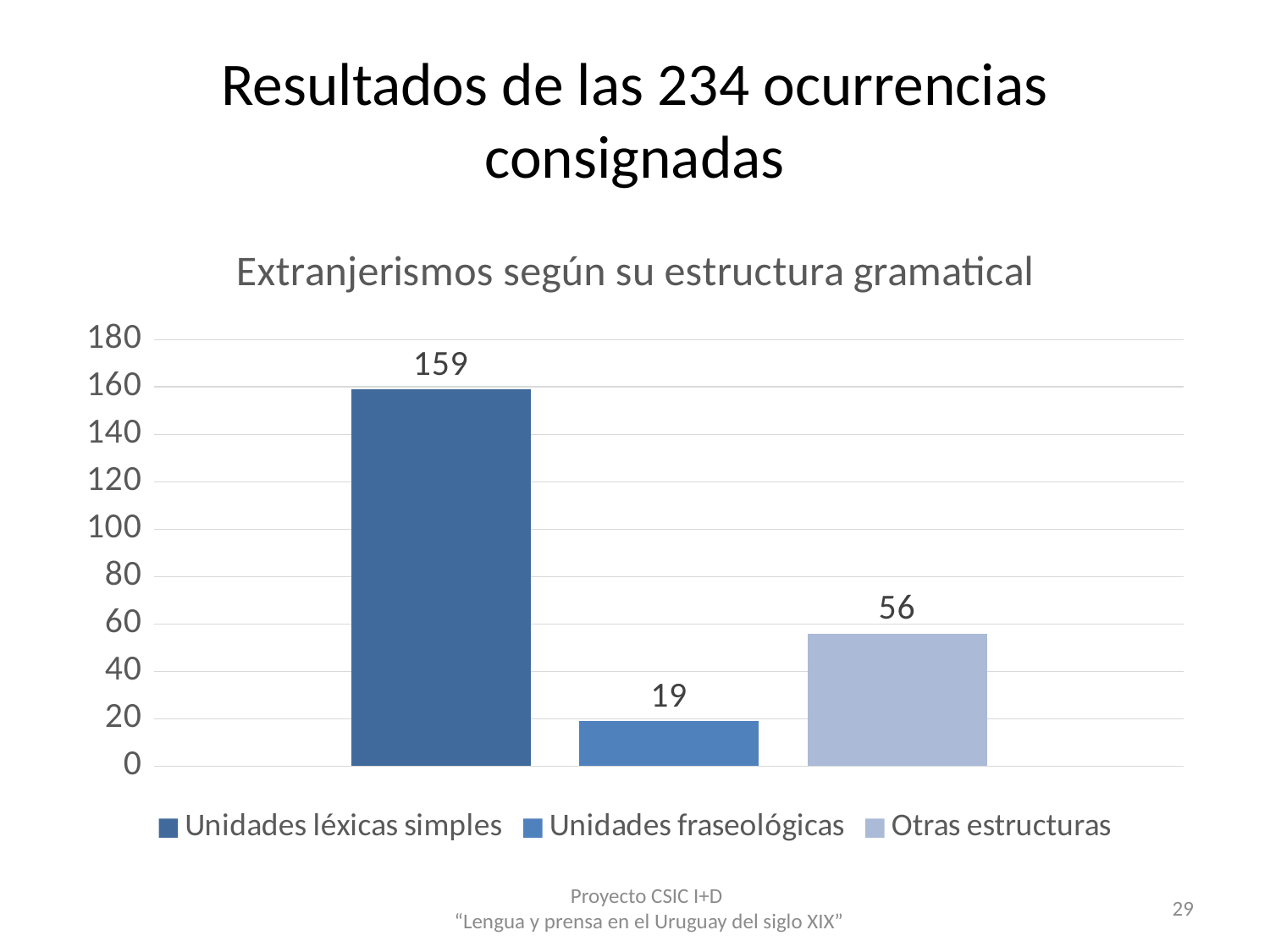
What is the value for Unidades léxicas simples? 159 What is the title of the chart? Extranjerismos según su estructura gramatical Is the value for Unidades léxicas simples greater or less than 140? greater Which category has the highest value? Unidades léxicas simples What is the value for Unidades fraseológicas? 19 Which category has the lowest value? Unidades fraseológicas What kind of chart is shown on the slide? bar chart What is the difference between the values for Otras estructuras and Unidades fraseológicas? 37 Which is larger, the value for Otras estructuras or the value for Unidades fraseológicas? Otras estructuras How many bars are shown in the chart? 3 What is the difference between the values for Unidades léxicas simples and Otras estructuras? 103 What is the value for Otras estructuras? 56